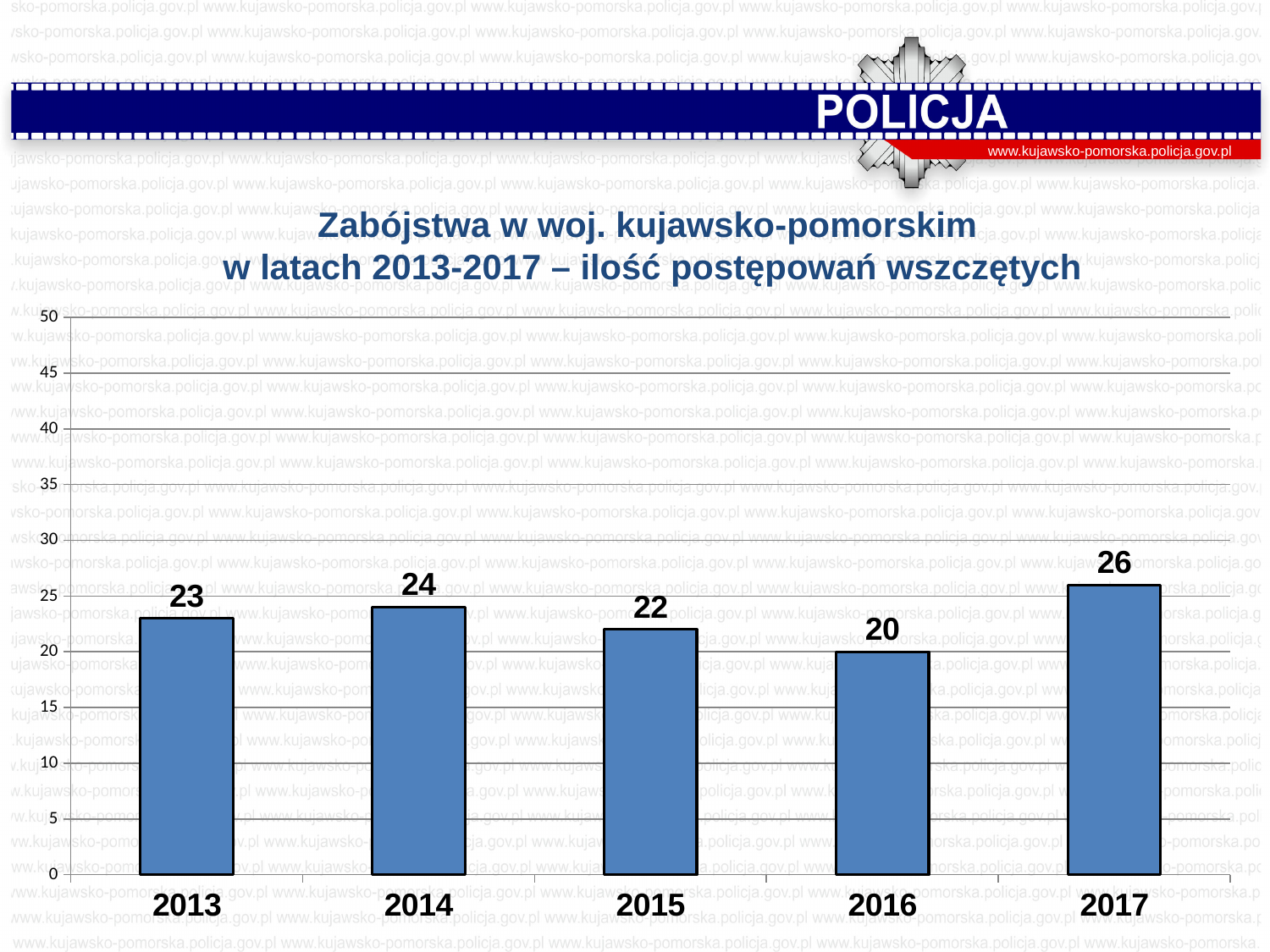
What is the value for 2016? 20 Which is larger, the value for 2014 or the value for 2015? 2014 Is the value for 2015 greater or less than 25? less What is the difference between the values for 2017 and 2016? 6 What is the value for 2013? 23 What kind of chart is shown on the slide? bar chart How many years are shown on the x axis? 5 Does the value rise or fall from 2016 to 2017? rise Which year has the highest value? 2017 Which year has the lowest value? 2016 What is the value for 2017? 26 What is the title of the chart? Zabójstwa w woj. kujawsko-pomorskim w latach 2013-2017 – ilość postępowań wszczętych